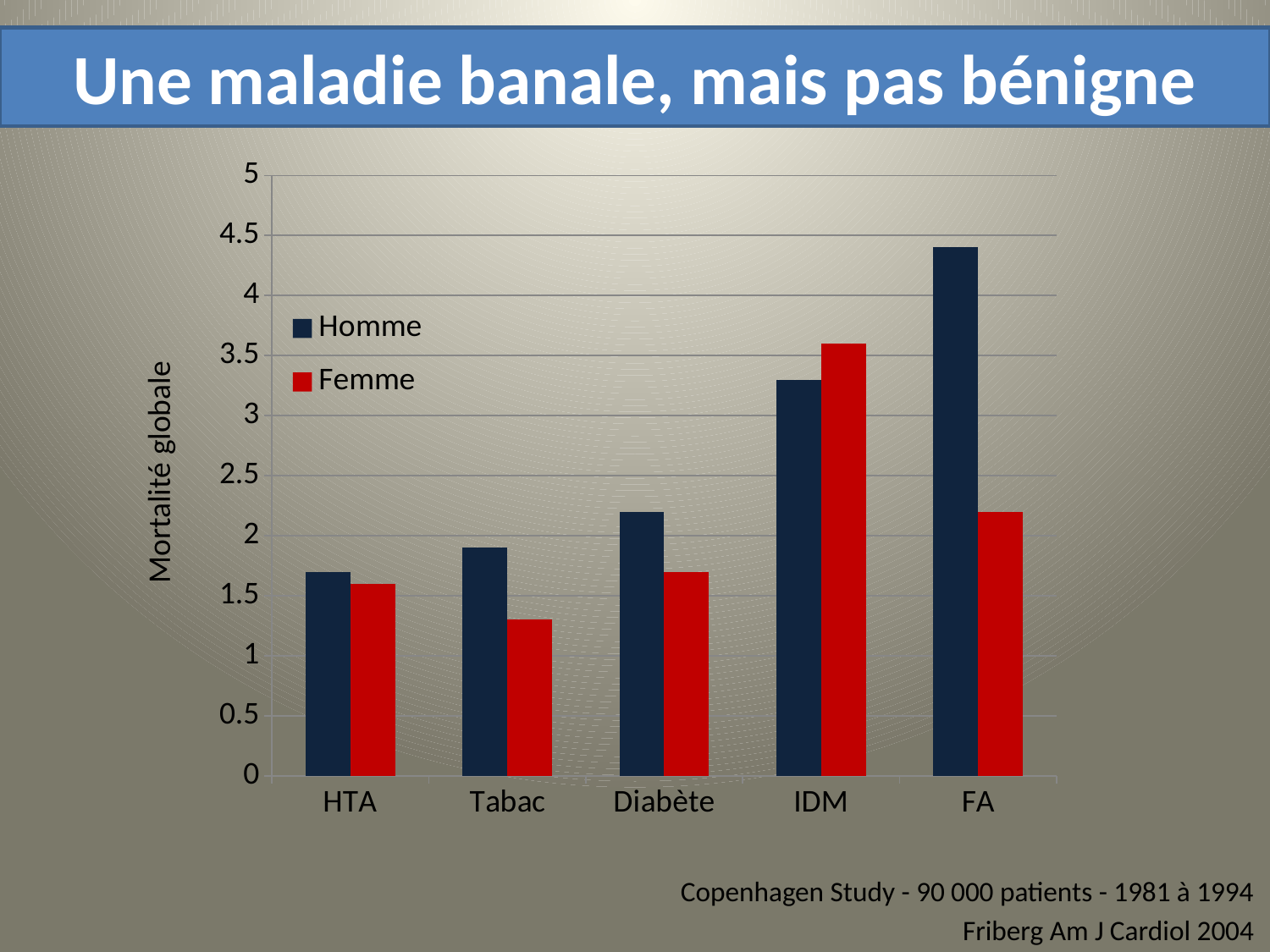
Which series is shown in red in the chart? Femme How many series does the chart's legend list? 2 How many categories are shown on the x axis of the chart? 5 For the Femme series, which category has the lowest value? Tabac Is the Homme value for FA greater or less than 4? greater Is the Femme value for Tabac greater or less than 1.5? less What kind of chart is shown on the slide? bar chart For FA, which is larger, the Homme value or the Femme value? Homme For the Homme series, which category has the highest value? FA For the Femme series, which category has the highest value? IDM What is the title of the vertical axis of the chart? Mortalité globale For IDM, which is larger, the Homme value or the Femme value? Femme